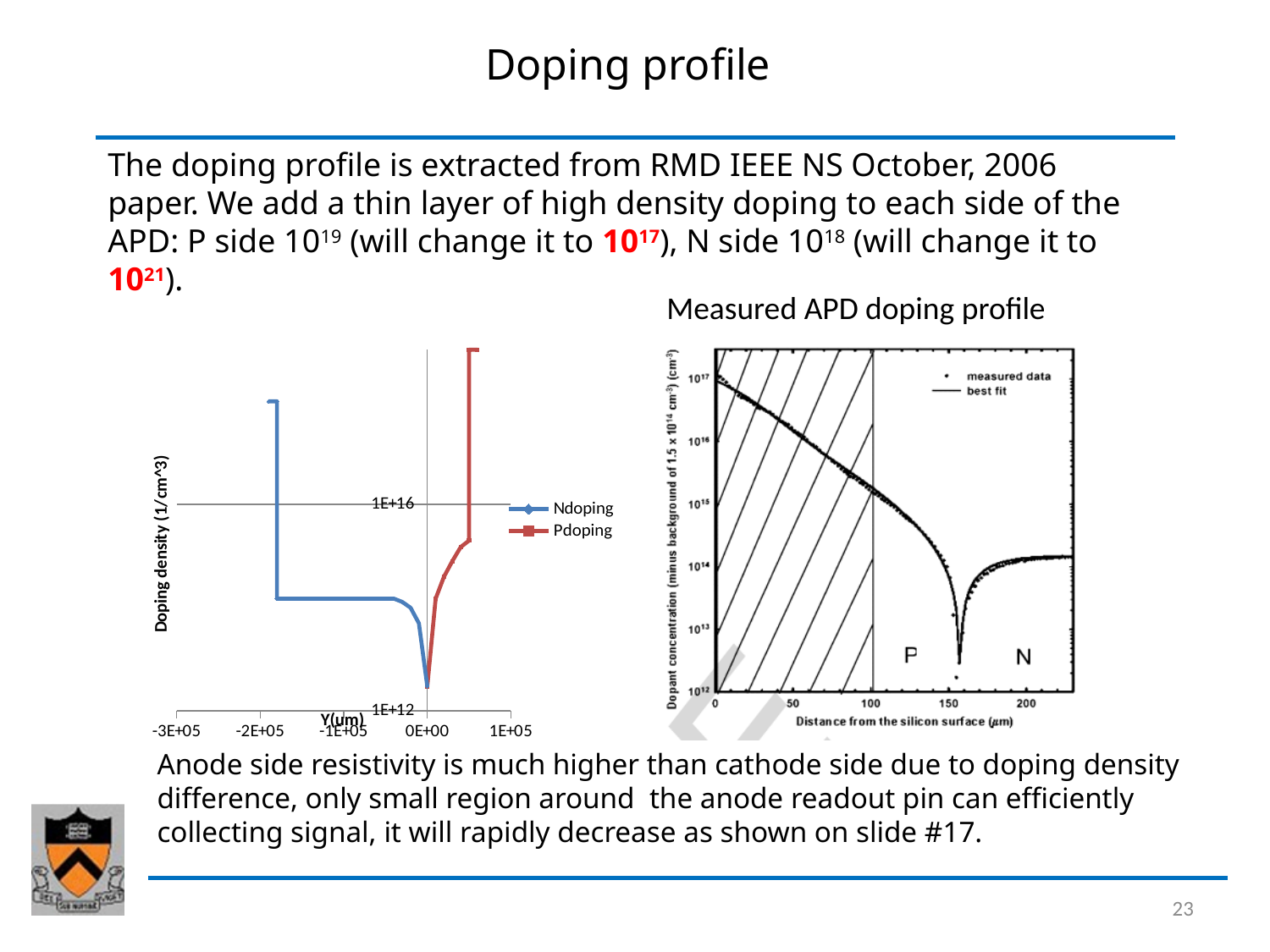
In the left chart, which series is plotted at negative values of Y(um)? Ndoping What are the two legend entries of the left chart? Ndoping, Pdoping What kind of chart is the left chart showing Ndoping and Pdoping? line chart In the left chart, is the peak value of the Ndoping series near Y = -2E+05 greater or less than 1E+16? greater How many series does the legend of the left chart list? 2 In the left chart, is the flat Ndoping level between Y = -2E+05 and 0E+00 greater or less than 1E+16? less In the left chart, what colour is the Ndoping series drawn in? blue How many series does the legend of the 'Measured APD doping profile' chart list? 2 In the 'Measured APD doping profile' chart, does the dopant concentration rise or fall as distance increases from 0 to 100 μm? fall In the 'Measured APD doping profile' chart, is the dopant concentration at a distance of 200 μm greater or less than 10^15? less